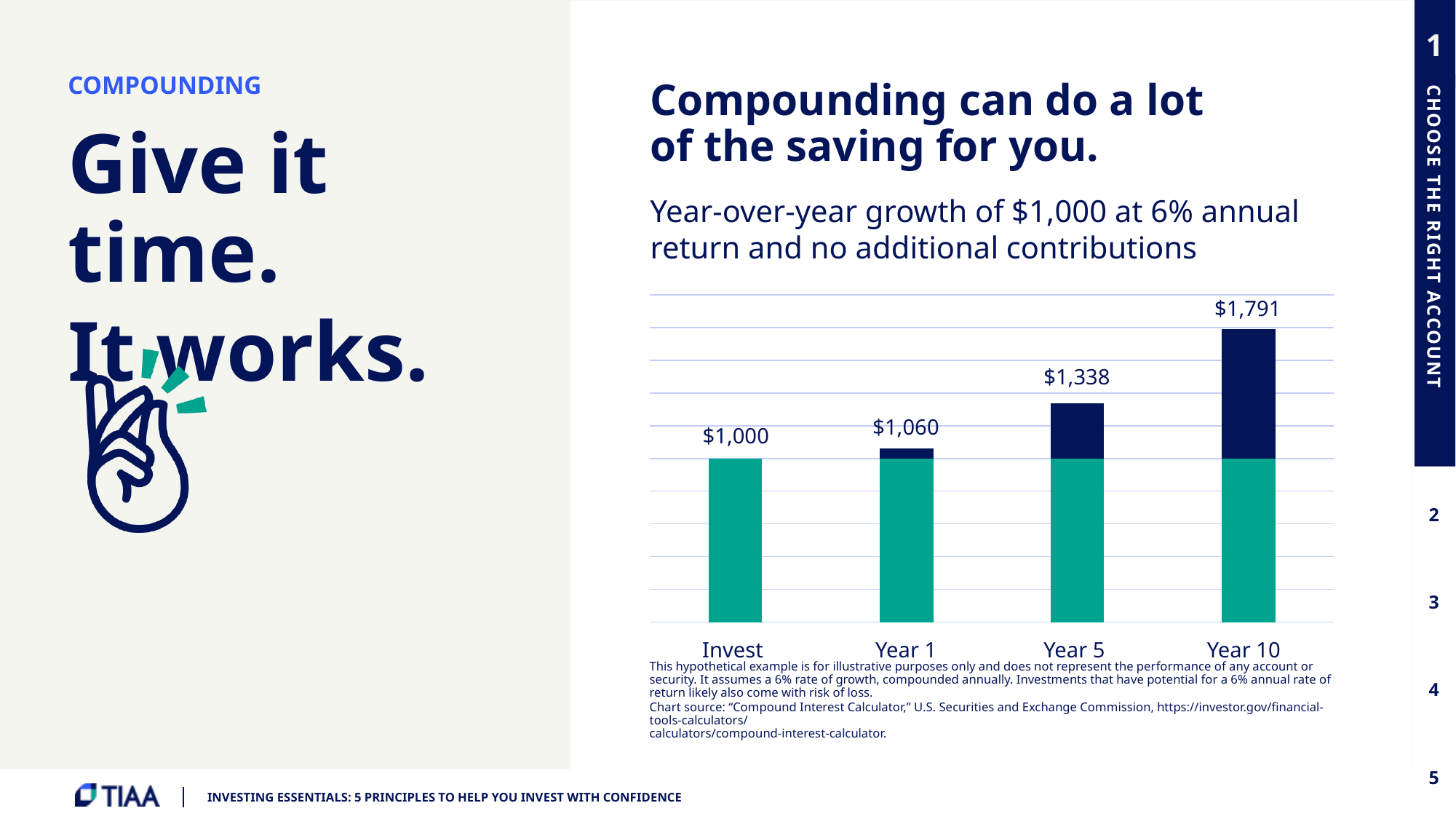
Which category has the highest value? Year 10 What kind of chart is shown on the slide? Bar chart Which category has the lowest value? Invest What is the difference between the Year 10 value and the Invest value? $791 How many bars are shown in the chart? 4 What is the value shown for Year 1? $1,060 Which is larger, the value for Year 5 or the value for Year 1? Year 5 What is the value shown for the Invest bar? $1,000 What is the value shown for Year 10? $1,791 What is the difference between the Year 5 value and the Year 1 value? $278 Do the values rise or fall from Invest to Year 10? Rise What is the value shown for Year 5? $1,338